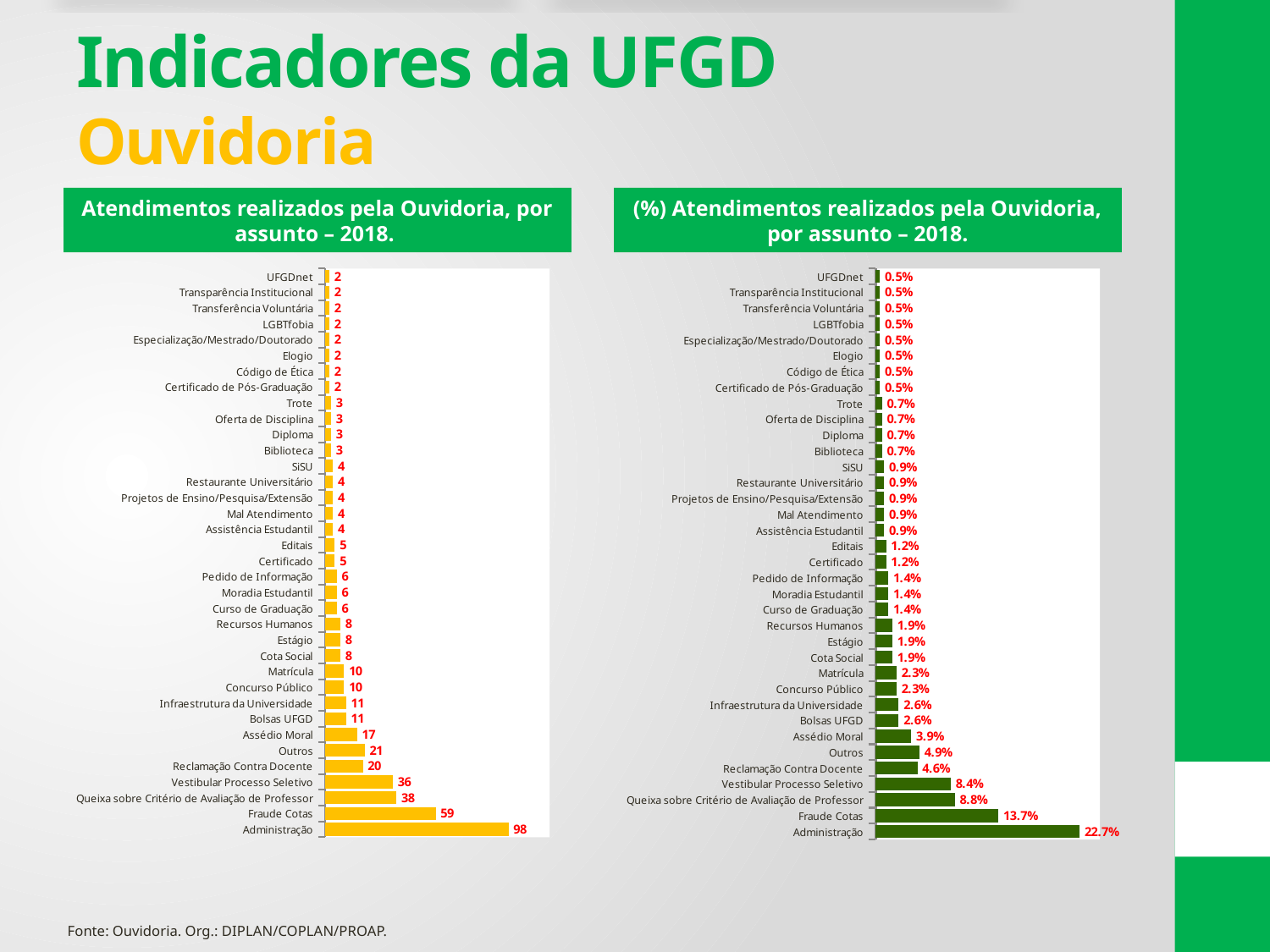
In the chart 'Atendimentos realizados pela Ouvidoria, por assunto – 2018', what is the value for Assédio Moral? 17 In the chart 'Atendimentos realizados pela Ouvidoria, por assunto – 2018', what is the value for Administração? 98 In the chart '(%) Atendimentos realizados pela Ouvidoria, por assunto – 2018', what is the value for Administração? 22.7% What type of chart is the chart '(%) Atendimentos realizados pela Ouvidoria, por assunto – 2018'? Bar chart In the chart 'Atendimentos realizados pela Ouvidoria, por assunto – 2018', what is the value for Fraude Cotas? 59 In the chart 'Atendimentos realizados pela Ouvidoria, por assunto – 2018', which is larger: Outros or Reclamação Contra Docente? Outros In the chart '(%) Atendimentos realizados pela Ouvidoria, por assunto – 2018', what is the value for Matrícula? 2.3% In the chart 'Atendimentos realizados pela Ouvidoria, por assunto – 2018', how many categories are shown? 36 In the chart 'Atendimentos realizados pela Ouvidoria, por assunto – 2018', what is the difference between Queixa sobre Critério de Avaliação de Professor and Vestibular Processo Seletivo? 2 In the chart '(%) Atendimentos realizados pela Ouvidoria, por assunto – 2018', what is the value for Vestibular Processo Seletivo? 8.4% In the chart '(%) Atendimentos realizados pela Ouvidoria, por assunto – 2018', what is the difference between Administração and Fraude Cotas? 9.0% In the chart 'Atendimentos realizados pela Ouvidoria, por assunto – 2018', which category has the highest value? Administração